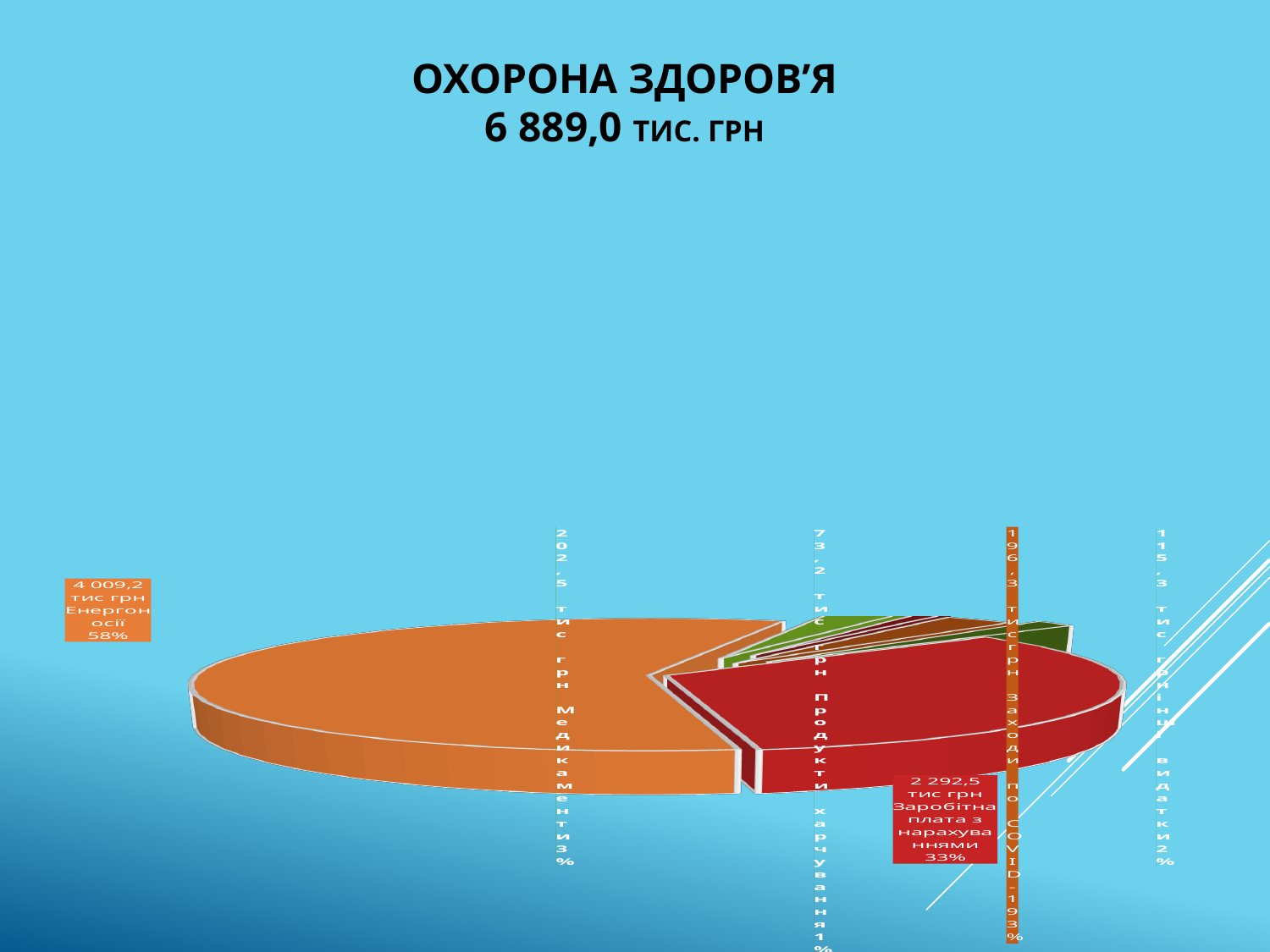
Which category has the smallest slice? Продукти харчування What kind of chart is shown on the slide? pie chart What is the value for Продукти харчування? 73,2 тис грн Which category has the largest slice? Енергоносії What share of the pie does Енергоносії take? 58% What share of the pie does Інші видатки take? 2% What is the value for Медикаменти? 202,5 тис грн What is the value for Заходи по COVID-19? 196,3 тис грн What is the title of the chart on the slide? ОХОРОНА ЗДОРОВ'Я 6 889,0 тис. грн What is the value for Заробітна плата з нарахуваннями? 2 292,5 тис грн What is the value for Енергоносії? 4 009,2 тис грн How many slices does the pie chart have? 6